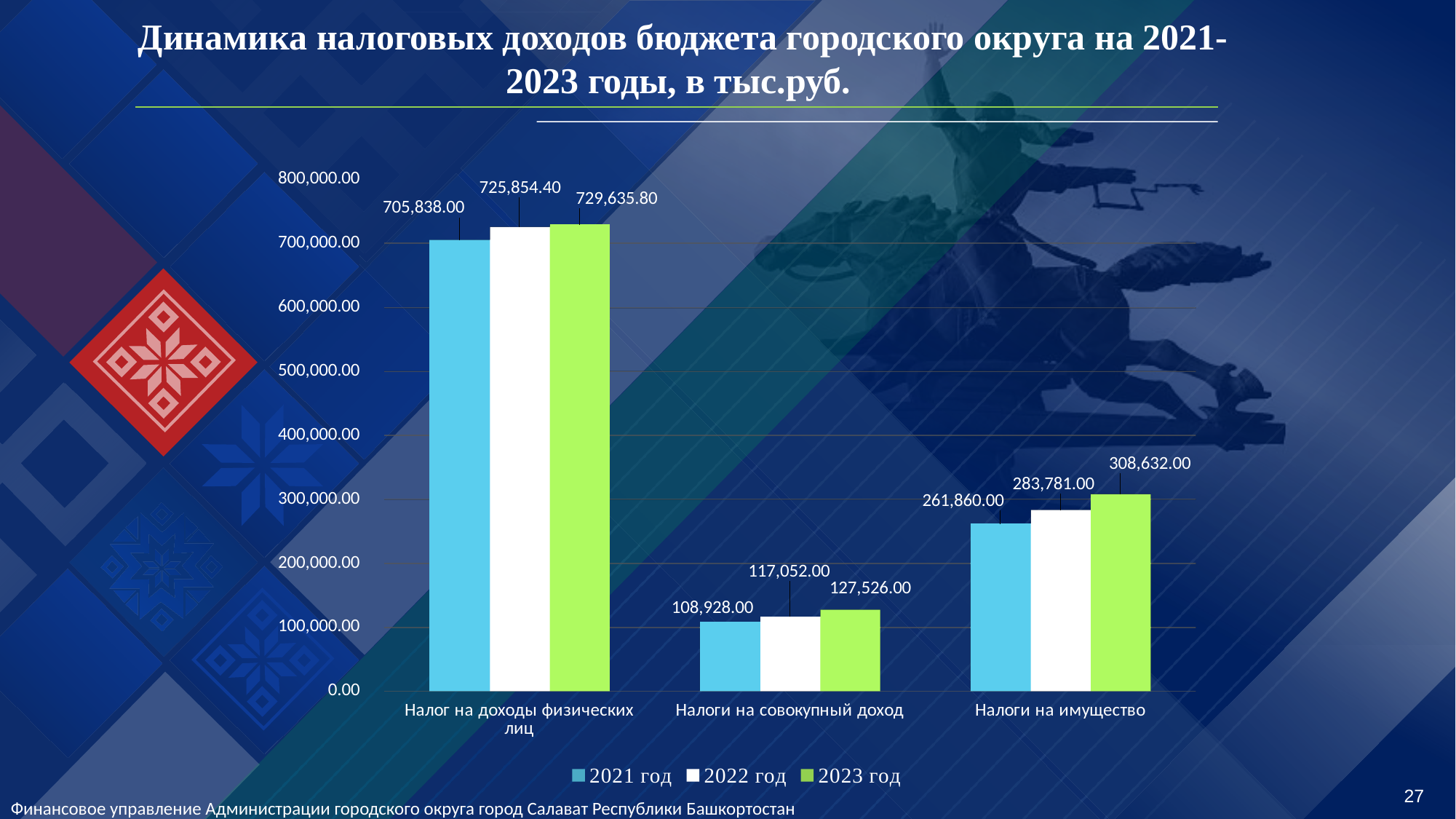
What is the difference between the 2023 год and 2021 год values for Налог на доходы физических лиц? 23,797.80 How many series does the legend list? 3 What kind of chart is shown on the slide? bar chart What is the value for Налоги на имущество in 2022 год? 283,781.00 How many categories are shown on the x axis? 3 Which category has the highest value in 2023 год? Налог на доходы физических лиц Which is larger: the 2022 год value for Налоги на имущество or the 2022 год value for Налоги на совокупный доход? Налоги на имущество What is the value for Налоги на совокупный доход in 2023 год? 127,526.00 Which category has the lowest value in 2021 год? Налоги на совокупный доход Is the 2023 год value for Налоги на имущество greater or less than 300,000.00? greater What is the difference between the 2023 год and 2021 год values for Налоги на имущество? 46,772.00 What is the value for Налог на доходы физических лиц in 2021 год? 705,838.00